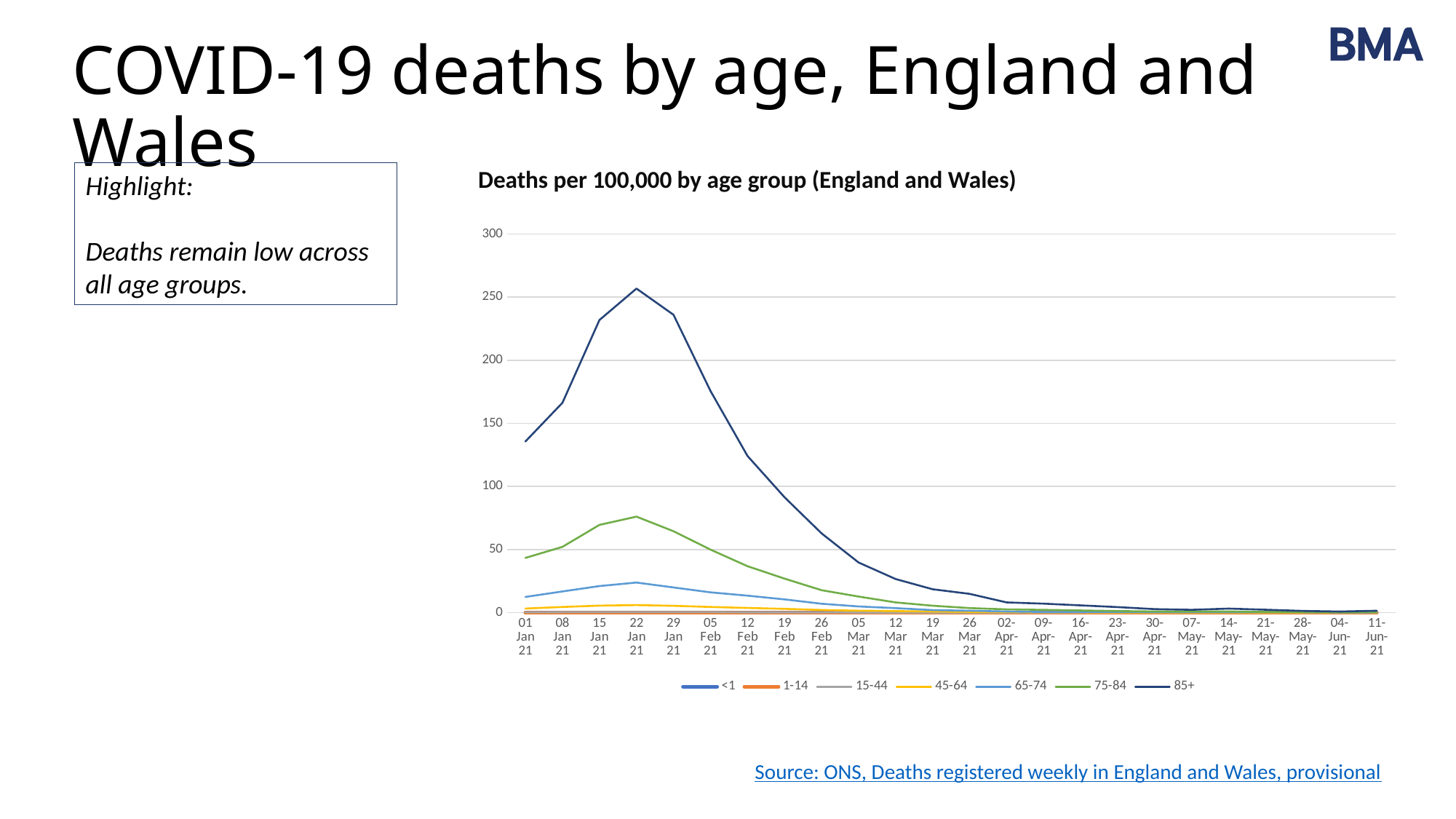
Does the 85+ line rise or fall between 22 Jan 21 and 11 Jun 21? fall Is the value for the 85+ group on 15 Jan 21 greater or less than 200? greater Is the value for the 75-84 group on 22 Jan 21 greater or less than 50? greater How many dates are shown along the x axis? 24 On which date does the 85+ line reach its peak? 22 Jan 21 Which age group has the highest deaths per 100,000 throughout the period? 85+ Is the value for the 65-74 group on 22 Jan 21 greater or less than 50? less What kind of chart is shown on the slide? line chart How many age-group series does the legend list? 7 Which is larger on 22 Jan 21: the value for 75-84 or the value for 65-74? 75-84